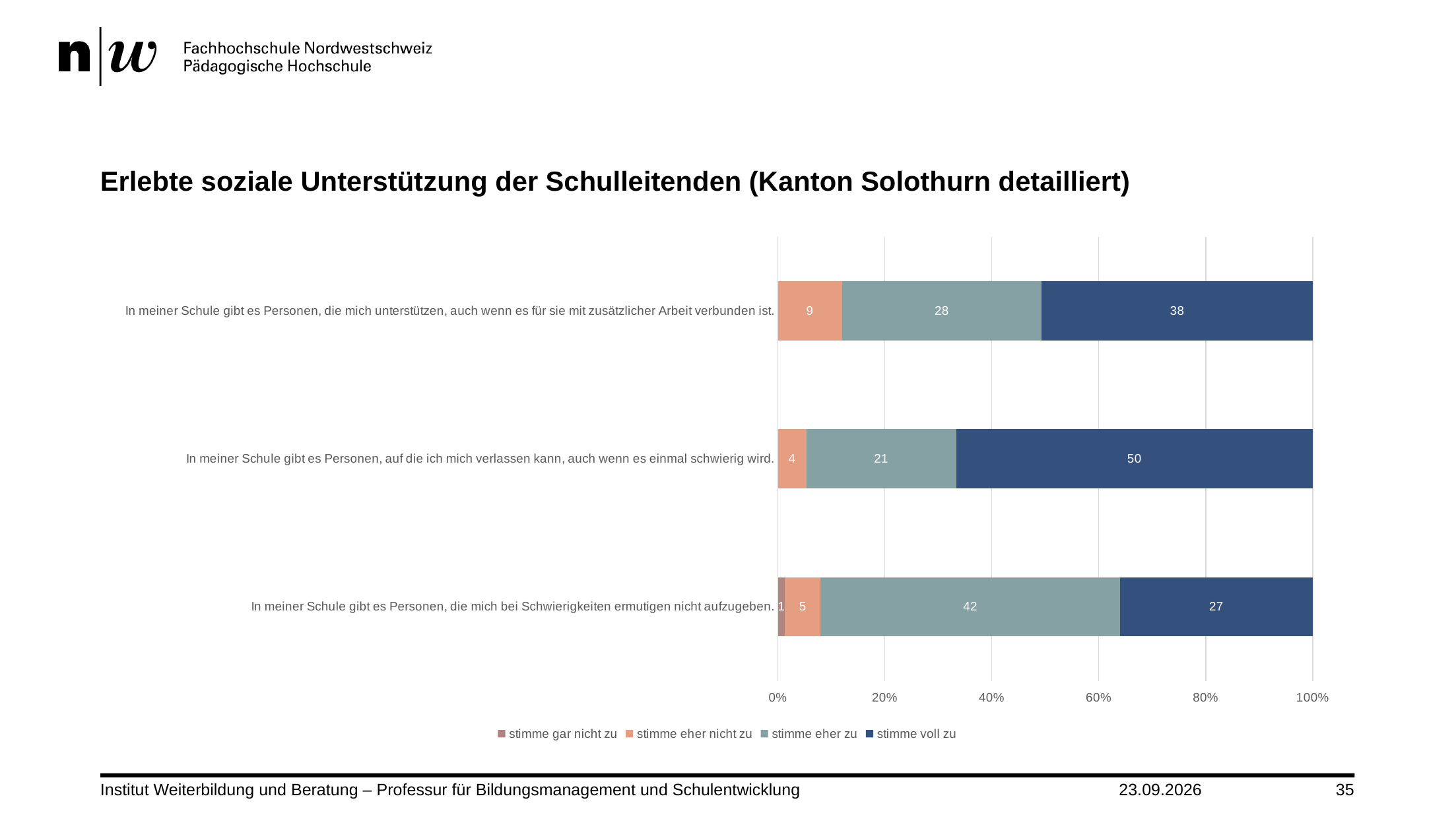
What is the value for "stimme eher nicht zu" for the statement "In meiner Schule gibt es Personen, die mich unterstützen, auch wenn es für sie mit zusätzlicher Arbeit verbunden ist."? 9 What is the value for "stimme eher zu" for the statement "In meiner Schule gibt es Personen, die mich bei Schwierigkeiten ermutigen nicht aufzugeben."? 42 Which is larger: the "stimme eher nicht zu" value for the statement about Personen, die mich unterstützen, or for the statement about Personen, die mich bei Schwierigkeiten ermutigen? Personen, die mich unterstützen (9) What is the value for "stimme voll zu" for the statement "In meiner Schule gibt es Personen, auf die ich mich verlassen kann, auch wenn es einmal schwierig wird."? 50 How many statements (categories) are plotted in the chart? 3 Which statement has the highest value for "stimme voll zu"? In meiner Schule gibt es Personen, auf die ich mich verlassen kann, auch wenn es einmal schwierig wird. What kind of chart is shown on the slide? stacked bar chart How many series does the legend list? 4 What is the difference between the "stimme voll zu" values for the statement about Personen, auf die ich mich verlassen kann, and the statement about Personen, die mich bei Schwierigkeiten ermutigen? 23 What is the total of all segments in the bar for the statement "In meiner Schule gibt es Personen, die mich bei Schwierigkeiten ermutigen nicht aufzugeben."? 75 What is the title of the chart on the slide? Erlebte soziale Unterstützung der Schulleitenden (Kanton Solothurn detailliert) Which statement has the lowest value for "stimme eher zu"? In meiner Schule gibt es Personen, auf die ich mich verlassen kann, auch wenn es einmal schwierig wird.